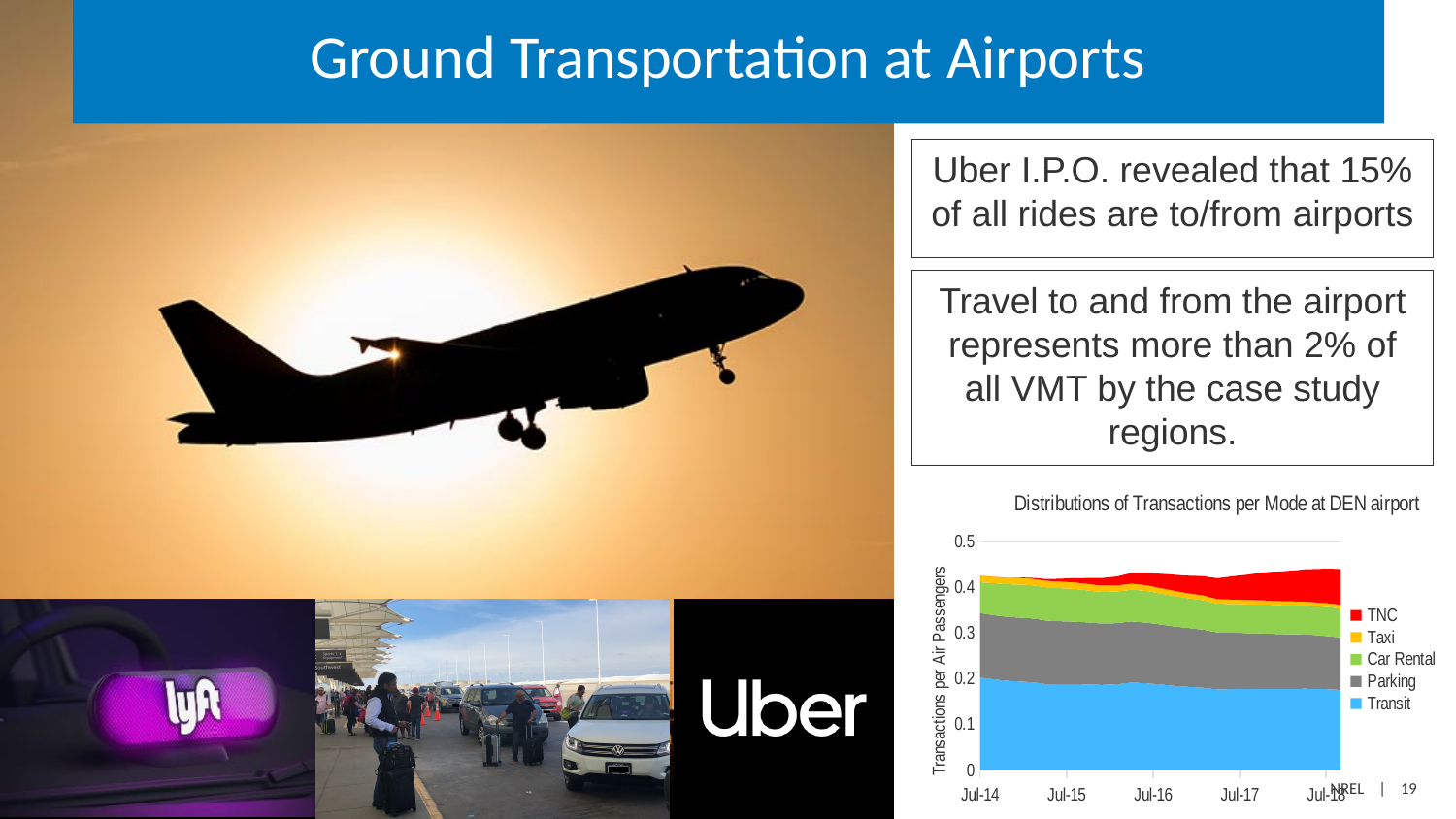
How many series does the chart's legend list? 5 Which mode forms the bottom layer of the stacked area chart? Transit Does the Taxi share of transactions rise or fall from Jul-14 to Jul-18? Fall What kind of chart is shown on the slide? Stacked area chart Is the total of all modes at Jul-18 greater or less than 0.5? less Does the TNC share of transactions rise or fall from Jul-14 to Jul-18? Rise What is the title of the chart on the slide? Distributions of Transactions per Mode at DEN airport Which mode has the larger share at Jul-18, Transit or Taxi? Transit How many labelled points are shown on the x axis of the chart? 5 Which modes are listed in the chart's legend? TNC, Taxi, Car Rental, Parking, Transit Is the total of all modes at Jul-14 greater or less than 0.4? greater